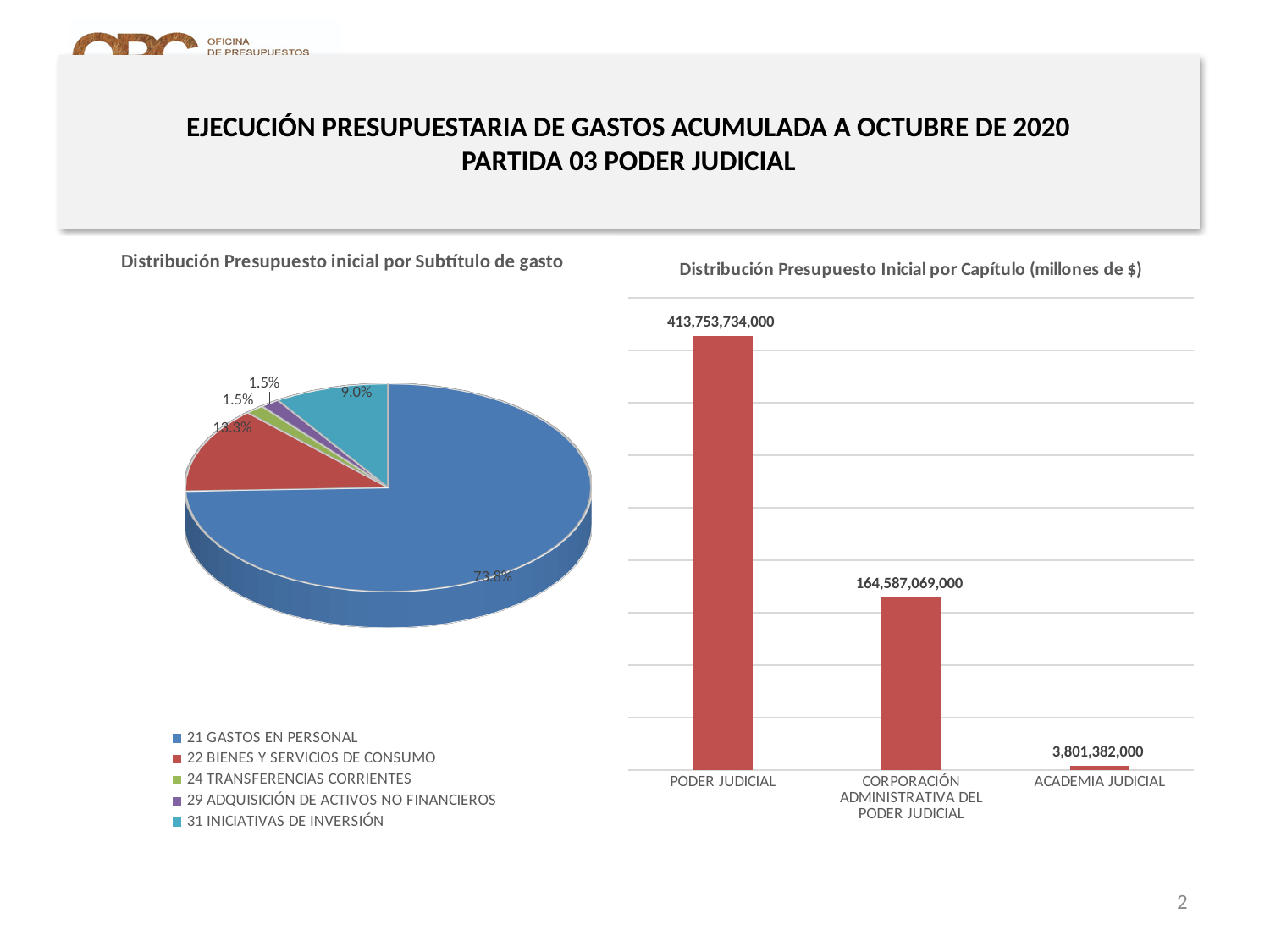
In the pie chart 'Distribución Presupuesto inicial por Subtítulo de gasto', what share does 21 GASTOS EN PERSONAL have? 73.8% In the pie chart 'Distribución Presupuesto inicial por Subtítulo de gasto', which is larger: 22 BIENES Y SERVICIOS DE CONSUMO or 31 INICIATIVAS DE INVERSIÓN? 22 BIENES Y SERVICIOS DE CONSUMO In the bar chart 'Distribución Presupuesto Inicial por Capítulo', which category has the highest value? PODER JUDICIAL In the bar chart 'Distribución Presupuesto Inicial por Capítulo', which category has the lowest value? ACADEMIA JUDICIAL In the bar chart 'Distribución Presupuesto Inicial por Capítulo', how many categories are shown? 3 What kind of chart is 'Distribución Presupuesto Inicial por Capítulo (millones de $)'? Bar chart In the bar chart 'Distribución Presupuesto Inicial por Capítulo', what is the value for PODER JUDICIAL? 413,753,734,000 In the bar chart 'Distribución Presupuesto Inicial por Capítulo', what is the value for CORPORACIÓN ADMINISTRATIVA DEL PODER JUDICIAL? 164,587,069,000 In the bar chart 'Distribución Presupuesto Inicial por Capítulo', what is the difference between PODER JUDICIAL and CORPORACIÓN ADMINISTRATIVA DEL PODER JUDICIAL? 249,166,665,000 How many entries does the legend of the pie chart 'Distribución Presupuesto inicial por Subtítulo de gasto' list? 5 In the bar chart 'Distribución Presupuesto Inicial por Capítulo', what is the value for ACADEMIA JUDICIAL? 3,801,382,000 In the pie chart 'Distribución Presupuesto inicial por Subtítulo de gasto', what share does 31 INICIATIVAS DE INVERSIÓN have? 9.0%